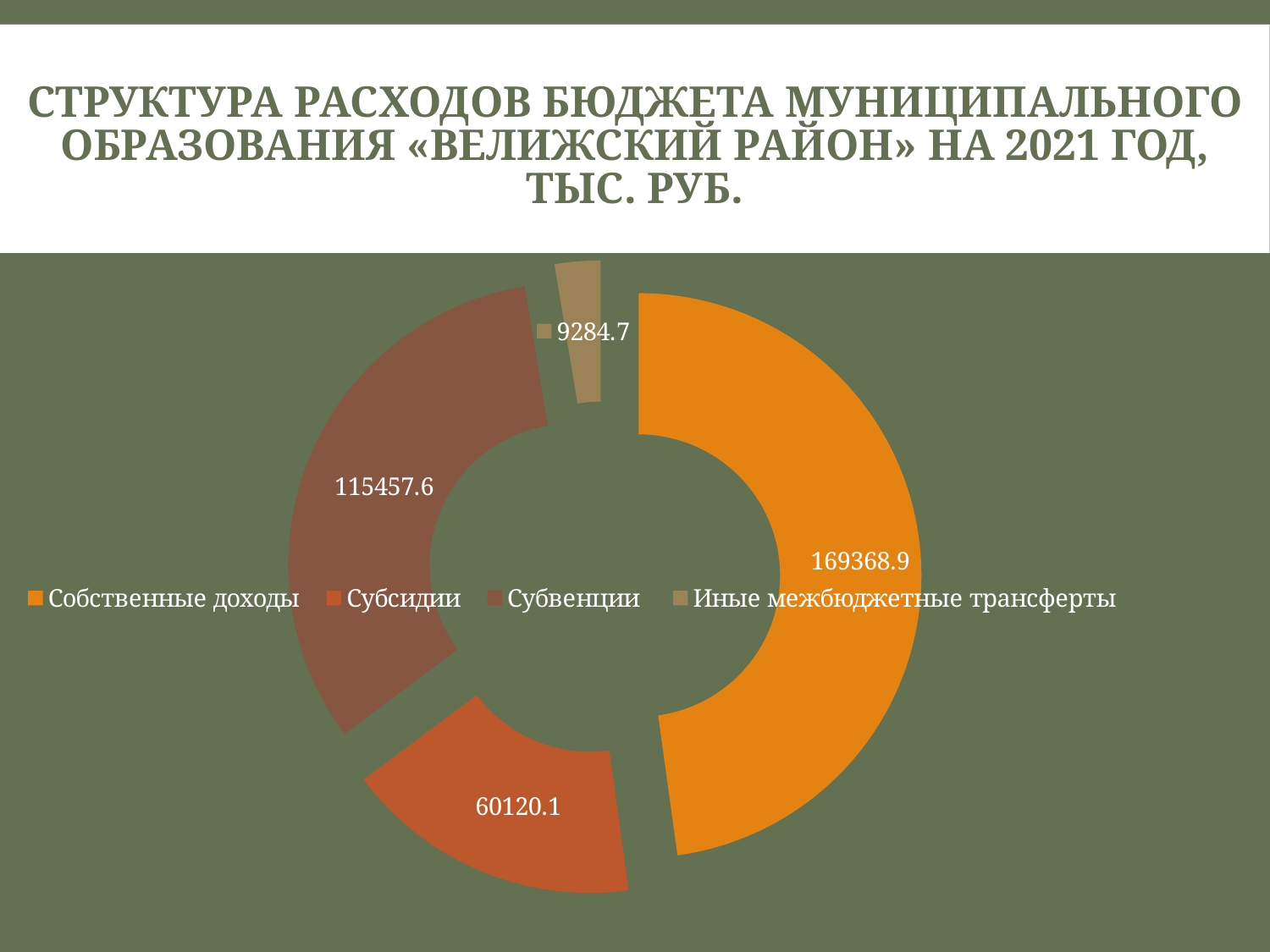
What is the value for Субвенции? 115457.6 Which category has the largest value? Собственные доходы Which is larger, Субсидии or Субвенции? Субвенции What is the value for Иные межбюджетные трансферты? 9284.7 What is the difference between Субвенции and Субсидии? 55337.5 What is the value for Субсидии? 60120.1 What is the difference between Собственные доходы and Субвенции? 53911.3 How many categories does the chart show? 4 What is the value for Собственные доходы? 169368.9 What kind of chart is shown on the slide? doughnut chart Which category has the smallest value? Иные межбюджетные трансферты What colour is the Собственные доходы slice? orange